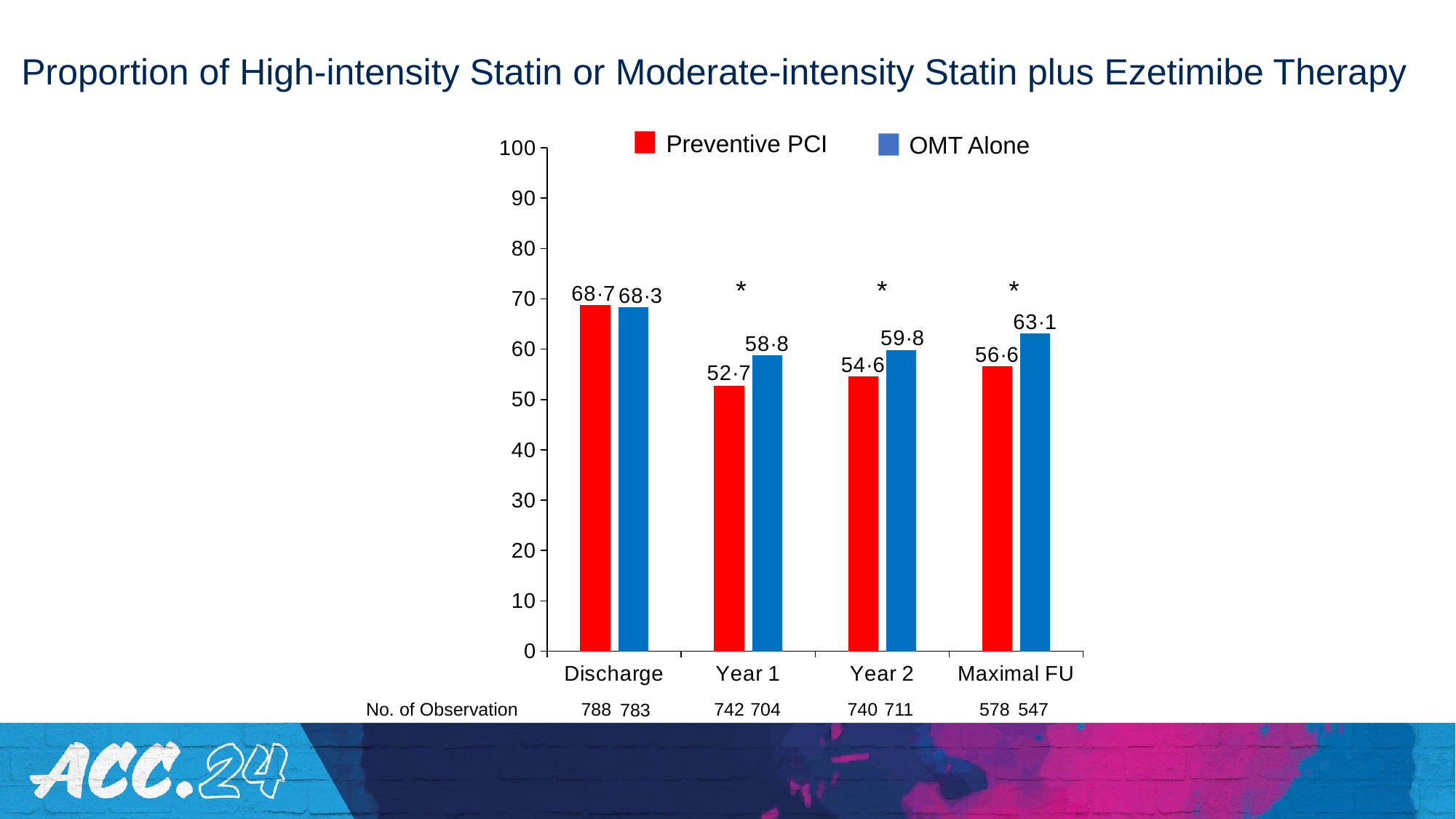
What is the value for Preventive PCI at Discharge? 68·7 What is the value for Preventive PCI at Year 2? 54·6 At which time point is the OMT Alone value highest? Discharge At which time point is the Preventive PCI value lowest? Year 1 How many time points are shown on the x axis? 4 How many series does the legend list? 2 What is the value for OMT Alone at Year 1? 58·8 Is the value for Preventive PCI at Year 2 greater or less than 60? less At Year 1, which series has the larger value, Preventive PCI or OMT Alone? OMT Alone What is the value for OMT Alone at Maximal FU? 63·1 What kind of chart is shown on the slide? bar chart What is the difference between the OMT Alone and Preventive PCI values at Maximal FU? 6·5